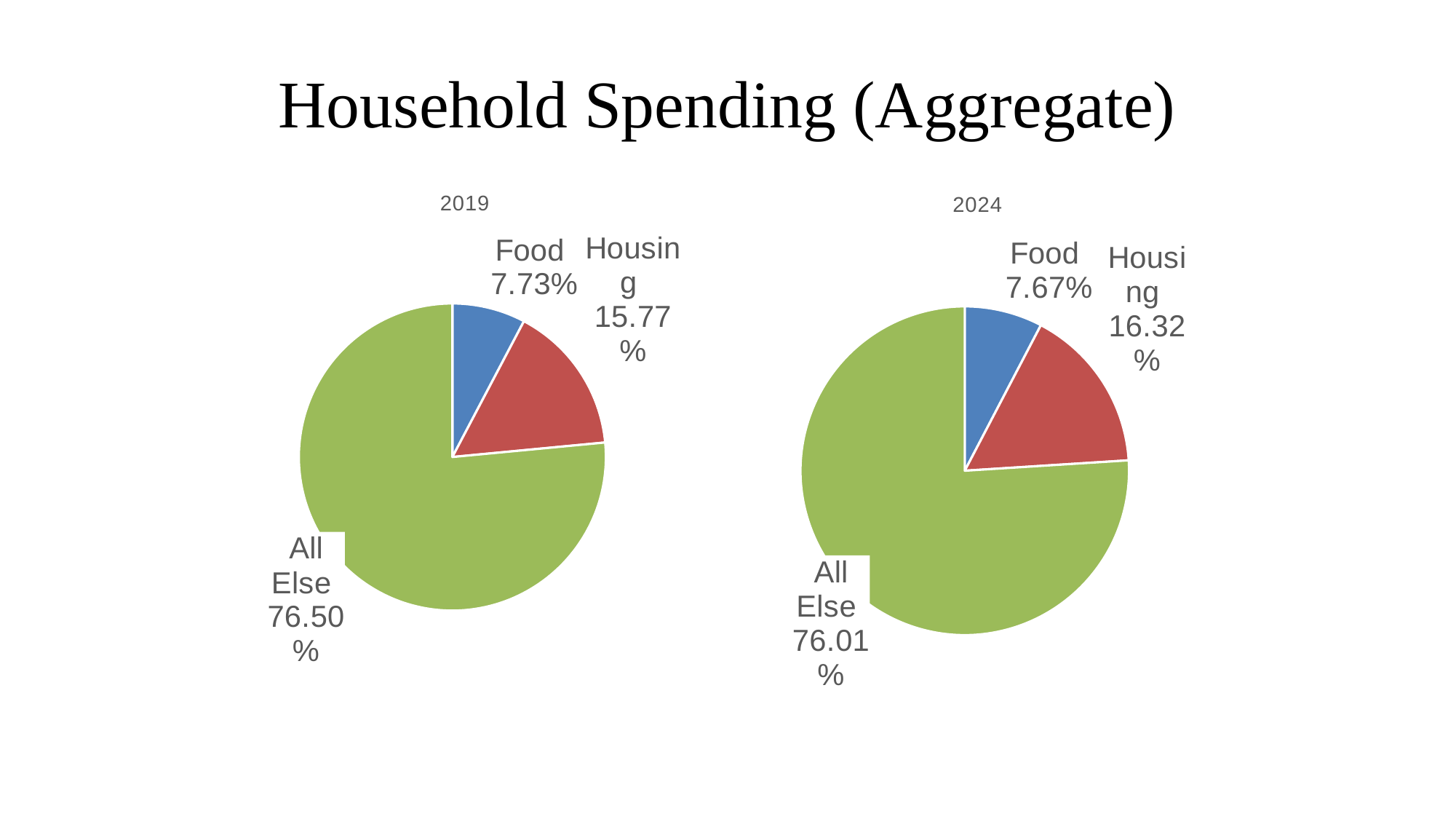
In the 2024 pie chart, what share does Food have? 7.67% How many categories does the 2019 pie chart show? 3 In the 2024 pie chart, what colour is the Housing slice? Red In the 2019 pie chart, what share does All Else have? 76.50% In the 2024 pie chart, what is the difference between the Housing share and the Food share? 8.65% What is the title of the chart on the left? 2019 In the 2019 pie chart, what share does Housing have? 15.77% In the 2024 pie chart, what share does Housing have? 16.32% What kind of chart is the 2024 chart? Pie chart In the 2019 pie chart, which is larger, the Food share or the Housing share? Housing In the 2019 pie chart, which category has the largest share? All Else In the 2024 pie chart, which category has the smallest share? Food